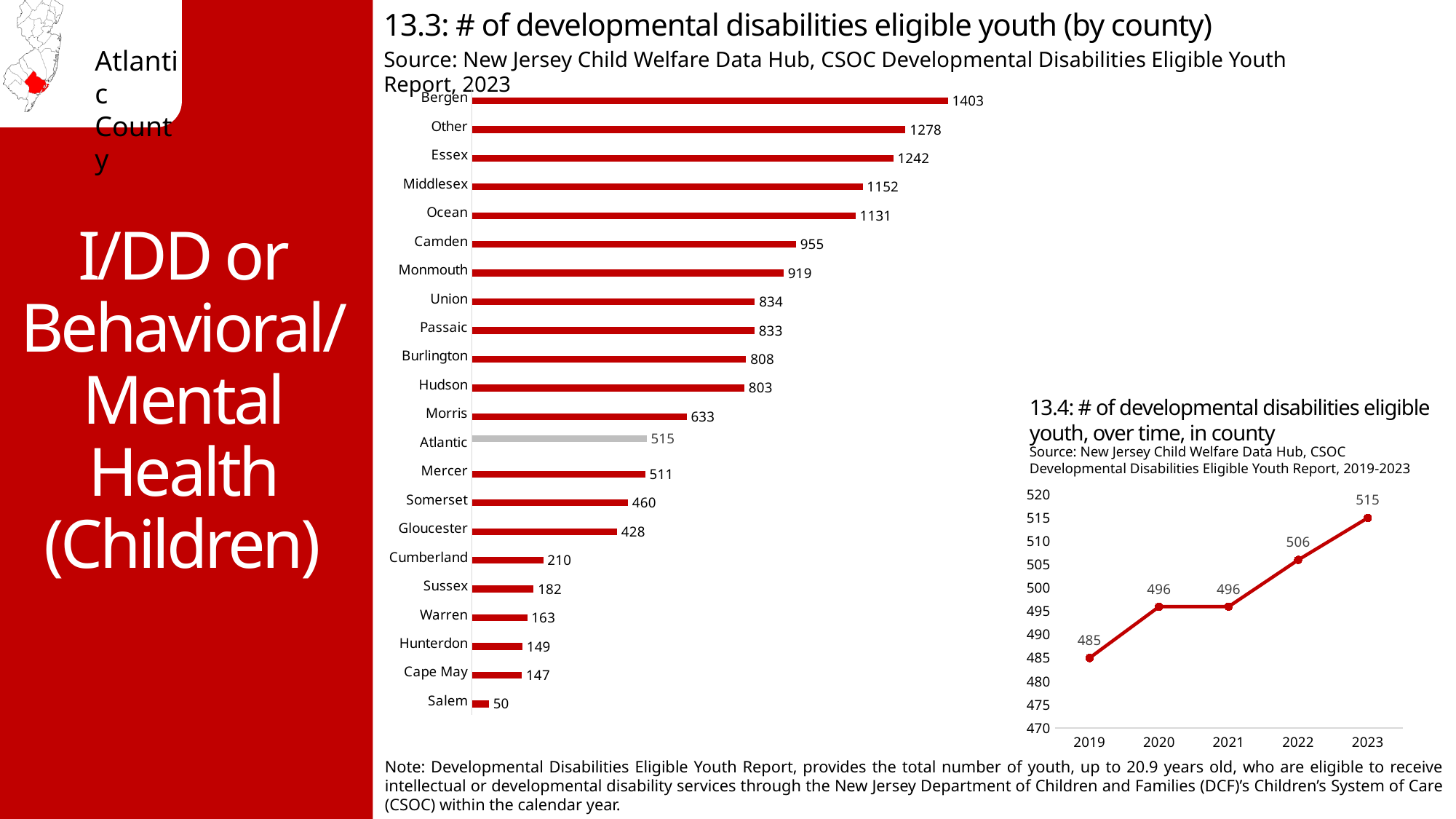
In chart 13.4 (over time, in county), what is the value for 2019? 485 In chart 13.4 (over time, in county), do the values generally rise or fall from 2019 to 2023? Rise In chart 13.3 (by county), which has a larger value, Camden or Monmouth? Camden In chart 13.3 (# of developmental disabilities eligible youth by county), what is the value for Atlantic? 515 What type of chart is chart 13.3 (# of developmental disabilities eligible youth by county)? Bar chart In chart 13.3 (by county), what is the value for Cumberland? 210 How many counties/categories are shown in chart 13.3 (by county)? 22 In chart 13.3 (by county), which county has the highest number of developmental disabilities eligible youth? Bergen In chart 13.4 (over time, in county), what is the difference between the 2023 and 2022 values? 9 In chart 13.3 (by county), which bar is shown in grey rather than red? Atlantic In chart 13.3 (by county), which county has the lowest number of developmental disabilities eligible youth? Salem In chart 13.3 (by county), what is the difference between the values for Bergen and Essex? 161